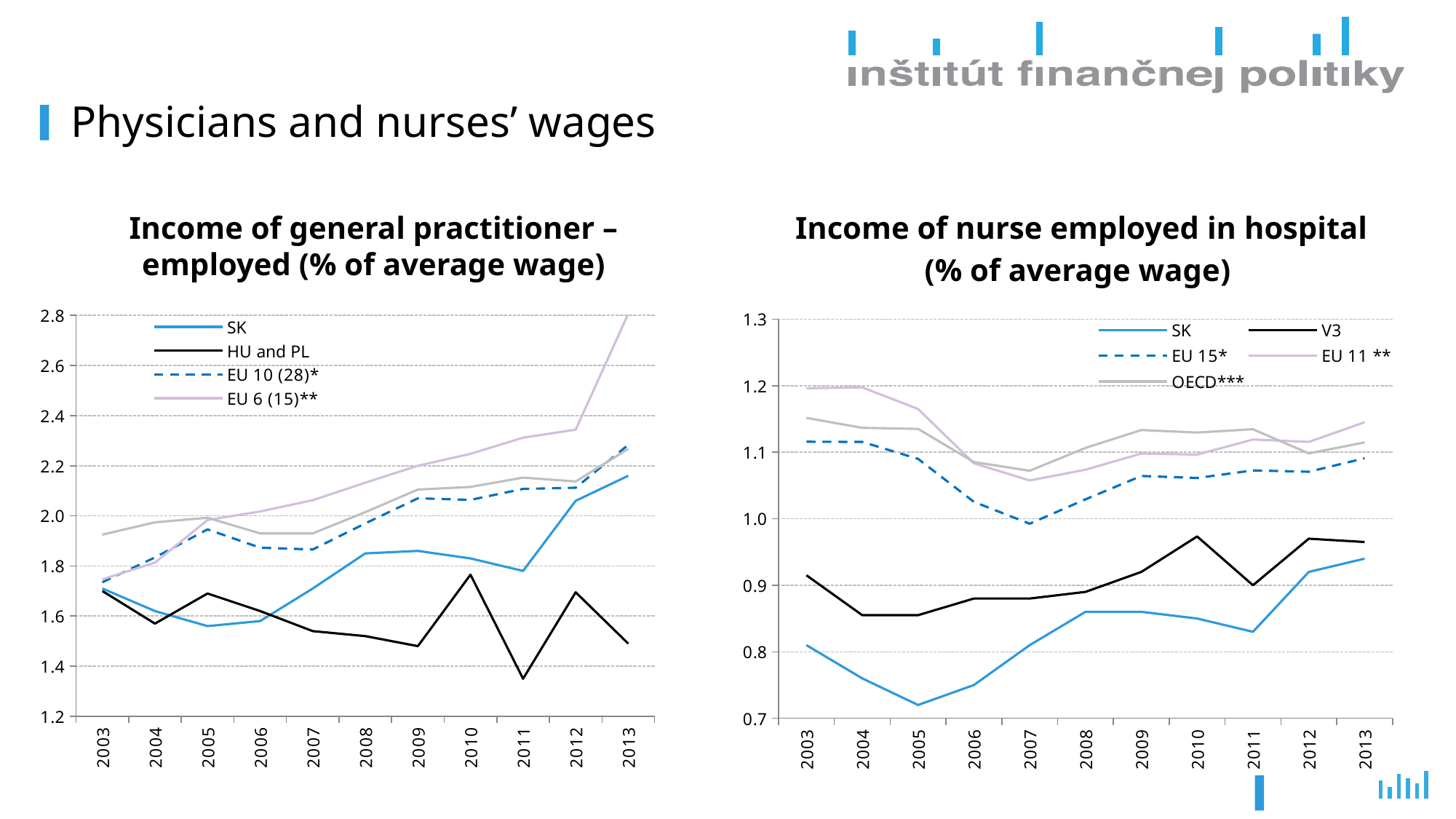
In the 'Income of general practitioner – employed (% of average wage)' chart, does the EU 6 (15)** series rise or fall from 2003 to 2013? rise In the 'Income of general practitioner – employed (% of average wage)' chart, is the value for HU and PL in 2011 greater or less than 1.4? less In the 'Income of nurse employed in hospital (% of average wage)' chart, is the value for SK in 2005 greater or less than 0.8? less In the 'Income of general practitioner – employed (% of average wage)' chart, which series has the highest value in 2013? EU 6 (15)** In the 'Income of nurse employed in hospital (% of average wage)' chart, which series has the highest value in 2003? EU 11 ** In the 'Income of nurse employed in hospital (% of average wage)' chart, which is larger in 2003, SK or V3? V3 In the 'Income of general practitioner – employed (% of average wage)' chart, is the value for SK in 2013 greater or less than 2.0? greater What type of chart is the 'Income of general practitioner – employed (% of average wage)' chart? line chart How many series does the legend of the 'Income of nurse employed in hospital (% of average wage)' chart list? 5 How many series does the legend of the 'Income of general practitioner – employed (% of average wage)' chart list? 4 In the 'Income of nurse employed in hospital (% of average wage)' chart, which series has the lowest value in 2013? SK How many years are shown on the x axis of the 'Income of nurse employed in hospital (% of average wage)' chart? 11